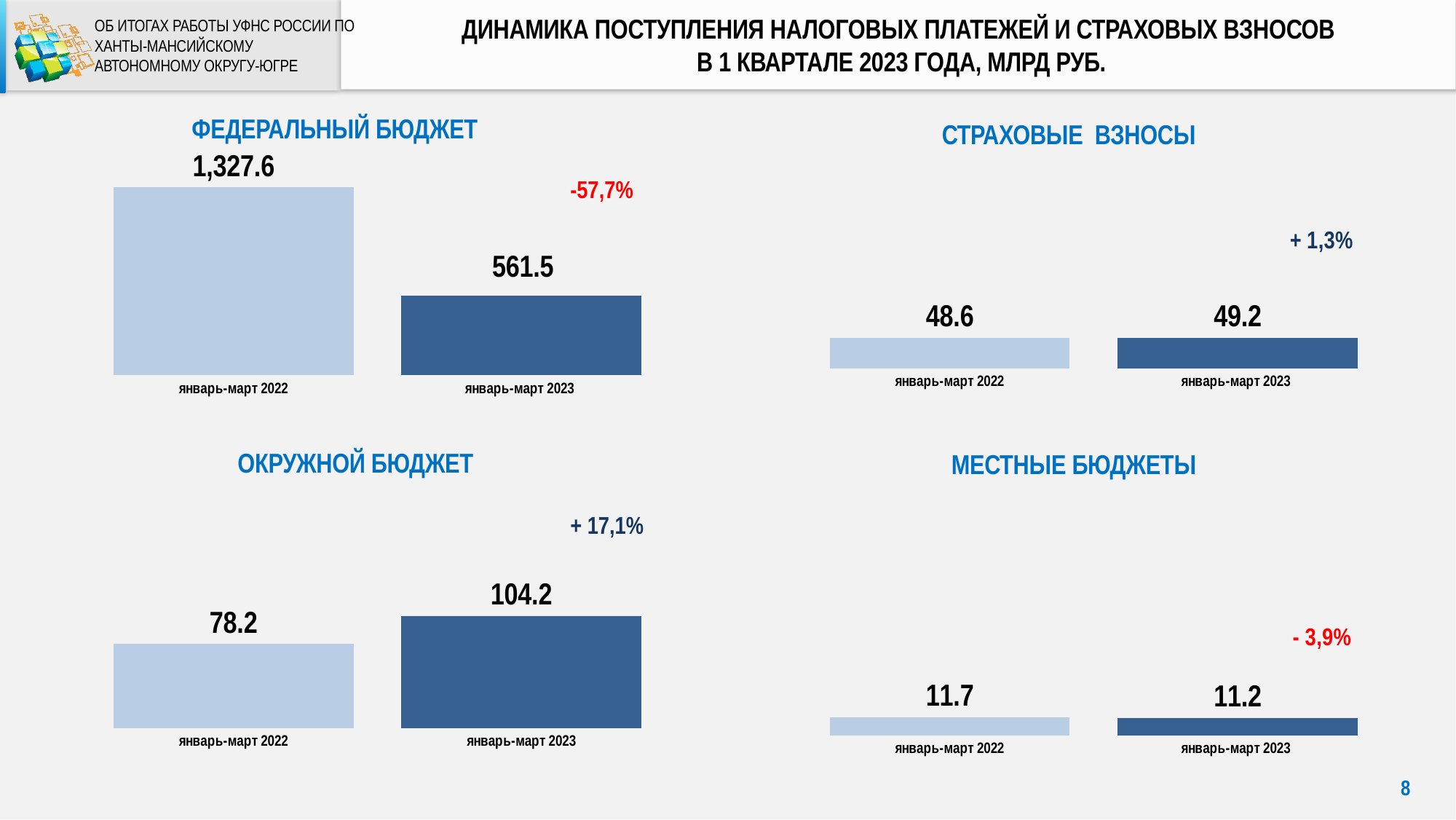
In the ФЕДЕРАЛЬНЫЙ БЮДЖЕТ chart, what is the difference between the январь-март 2022 and январь-март 2023 values? 766.1 In the МЕСТНЫЕ БЮДЖЕТЫ chart, which period has the lower value? январь-март 2023 In the ФЕДЕРАЛЬНЫЙ БЮДЖЕТ chart, what is the value for январь-март 2022? 1,327.6 In the ОКРУЖНОЙ БЮДЖЕТ chart, by how much does the январь-март 2023 value exceed the январь-март 2022 value? 26.0 In the СТРАХОВЫЕ ВЗНОСЫ chart, what is the value for январь-март 2022? 48.6 In the СТРАХОВЫЕ ВЗНОСЫ chart, which period has the larger value, январь-март 2022 or январь-март 2023? январь-март 2023 In the МЕСТНЫЕ БЮДЖЕТЫ chart, what is the value for январь-март 2023? 11.2 In the ФЕДЕРАЛЬНЫЙ БЮДЖЕТ chart, what is the value for январь-март 2023? 561.5 In the ОКРУЖНОЙ БЮДЖЕТ chart, what is the value for январь-март 2023? 104.2 What percentage change is shown on the ФЕДЕРАЛЬНЫЙ БЮДЖЕТ chart? -57,7% In the ОКРУЖНОЙ БЮДЖЕТ chart, do the values rise or fall from январь-март 2022 to январь-март 2023? rise What kind of chart is the ФЕДЕРАЛЬНЫЙ БЮДЖЕТ chart? bar chart